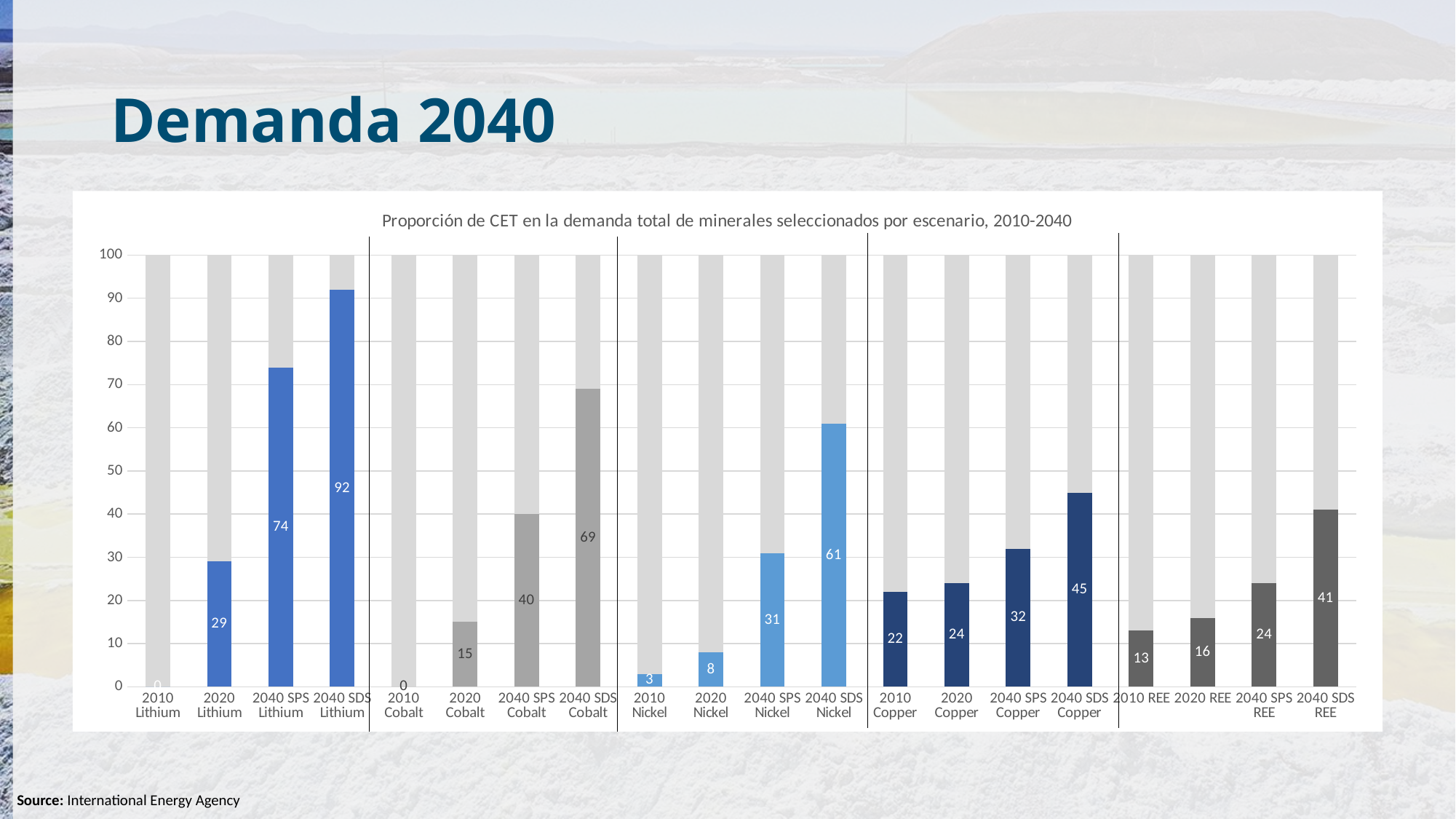
How many categories are shown on the x axis? 20 What is the difference between the values for 2040 SDS REE and 2010 REE? 28 Which category has the highest value in the chart? 2040 SDS Lithium What kind of chart is shown on the slide? Bar chart Is the value for 2040 SPS Lithium greater or less than 70? greater What is the title of the chart? Proporción de CET en la demanda total de minerales seleccionados por escenario, 2010-2040 What is the value for 2010 Copper? 22 What is the value for 2040 SPS Nickel? 31 What is the value for 2040 SDS Lithium? 92 Which is larger, the value for 2040 SDS Nickel or the value for 2040 SDS Copper? 2040 SDS Nickel What is the difference between the values for 2040 SDS Cobalt and 2040 SPS Cobalt? 29 What is the value for 2020 Cobalt? 15